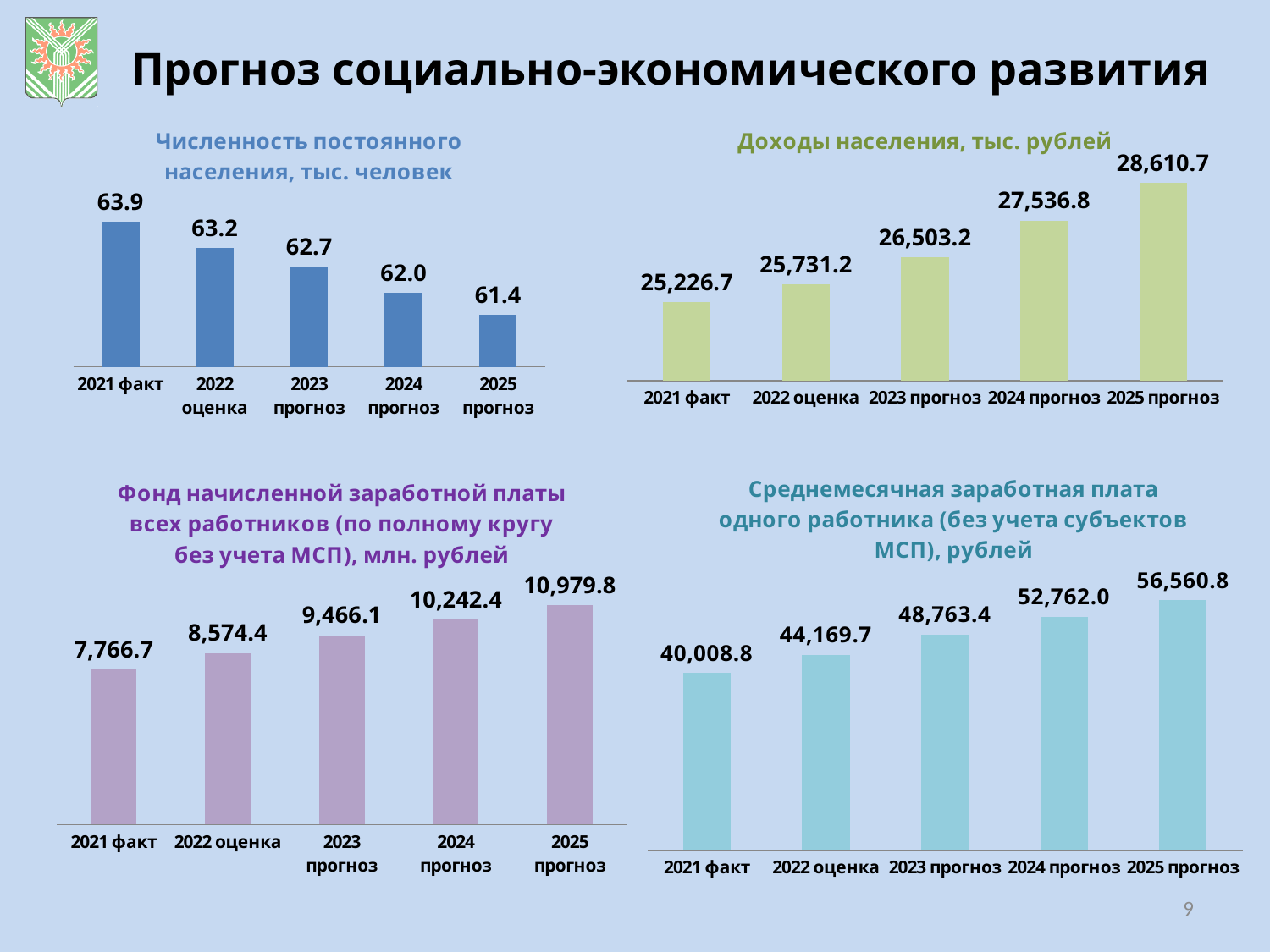
In the bottom-right chart (Среднемесячная заработная плата одного работника), which is larger: the value for 2022 оценка or 2023 прогноз? 2023 прогноз What kind of chart is the bottom-right chart (Среднемесячная заработная плата одного работника)? bar chart In the top-right chart (Доходы населения, тыс. рублей), what is the value for 2023 прогноз? 26,503.2 In the bottom-right chart (Среднемесячная заработная плата одного работника), what is the value for 2024 прогноз? 52,762.0 In the top-left chart (Численность постоянного населения, тыс. человек), what is the value for 2021 факт? 63.9 In the top-left chart (Численность постоянного населения, тыс. человек), what is the difference between the 2021 факт and 2025 прогноз values? 2.5 In the bottom-left chart (Фонд начисленной заработной платы), what is the value for 2022 оценка? 8,574.4 In the top-right chart (Доходы населения, тыс. рублей), which category has the highest value? 2025 прогноз In the top-right chart (Доходы населения, тыс. рублей), how many categories are shown on the x axis? 5 In the top-left chart (Численность постоянного населения, тыс. человек), which category has the lowest value? 2025 прогноз In the top-left chart (Численность постоянного населения, тыс. человек), do the values rise or fall from 2021 to 2025? fall In the bottom-left chart (Фонд начисленной заработной платы), what is the difference between the 2025 прогноз and 2021 факт values? 3,213.1